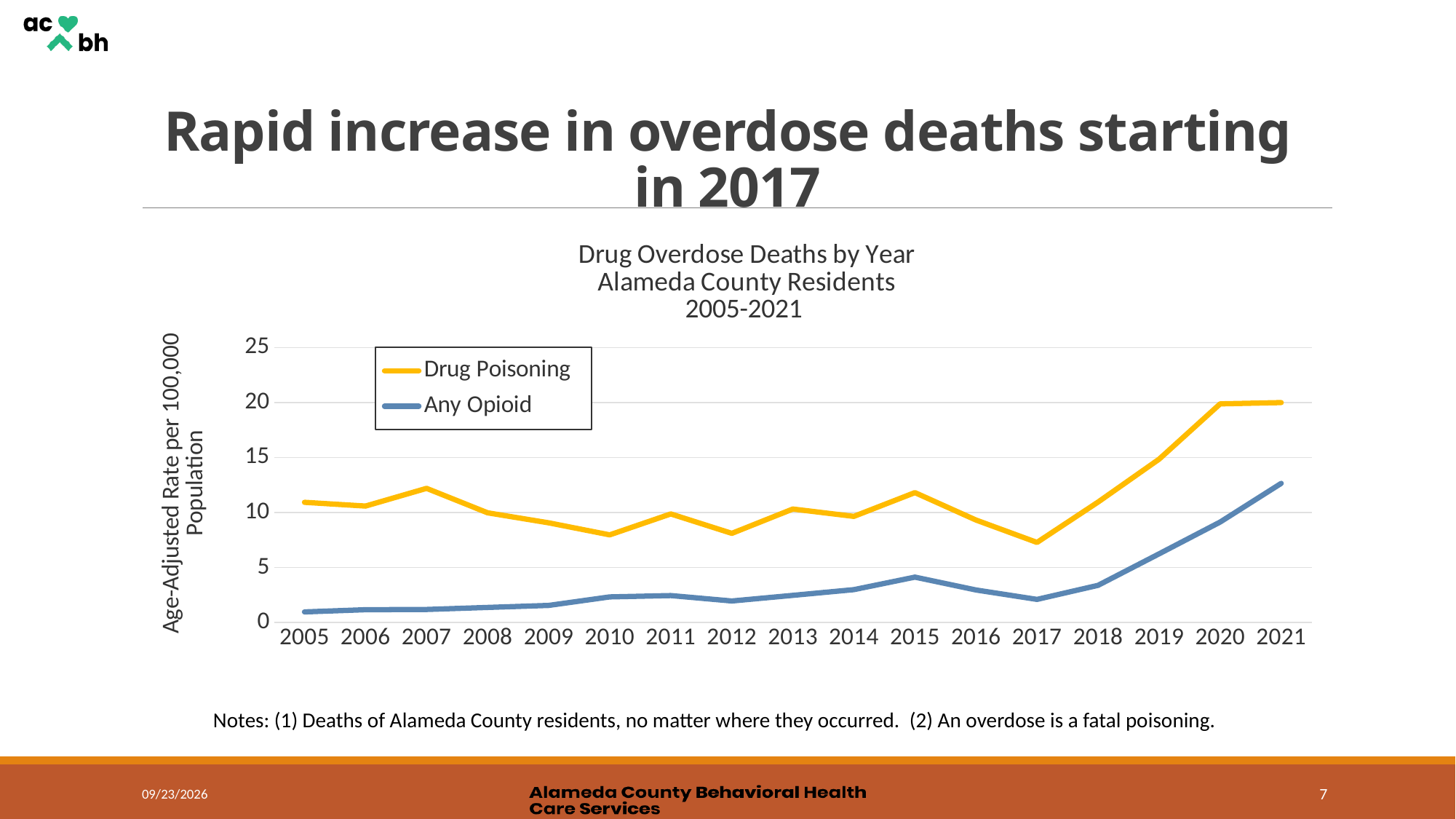
Which colour is used for the Drug Poisoning line? Yellow Is the Any Opioid value for 2015 greater or less than 5? less Does the Any Opioid rate rise or fall from 2017 to 2021? Rise How many series does the legend list? 2 How many years are plotted along the x axis? 17 What kind of chart is shown on the slide? Line chart Is the Drug Poisoning value for 2020 greater or less than 15? greater In which year is the Any Opioid rate highest? 2021 Is the Drug Poisoning value for 2017 greater or less than 10? less In which year is the Drug Poisoning rate lowest? 2017 In 2010, which series has the larger value, Drug Poisoning or Any Opioid? Drug Poisoning